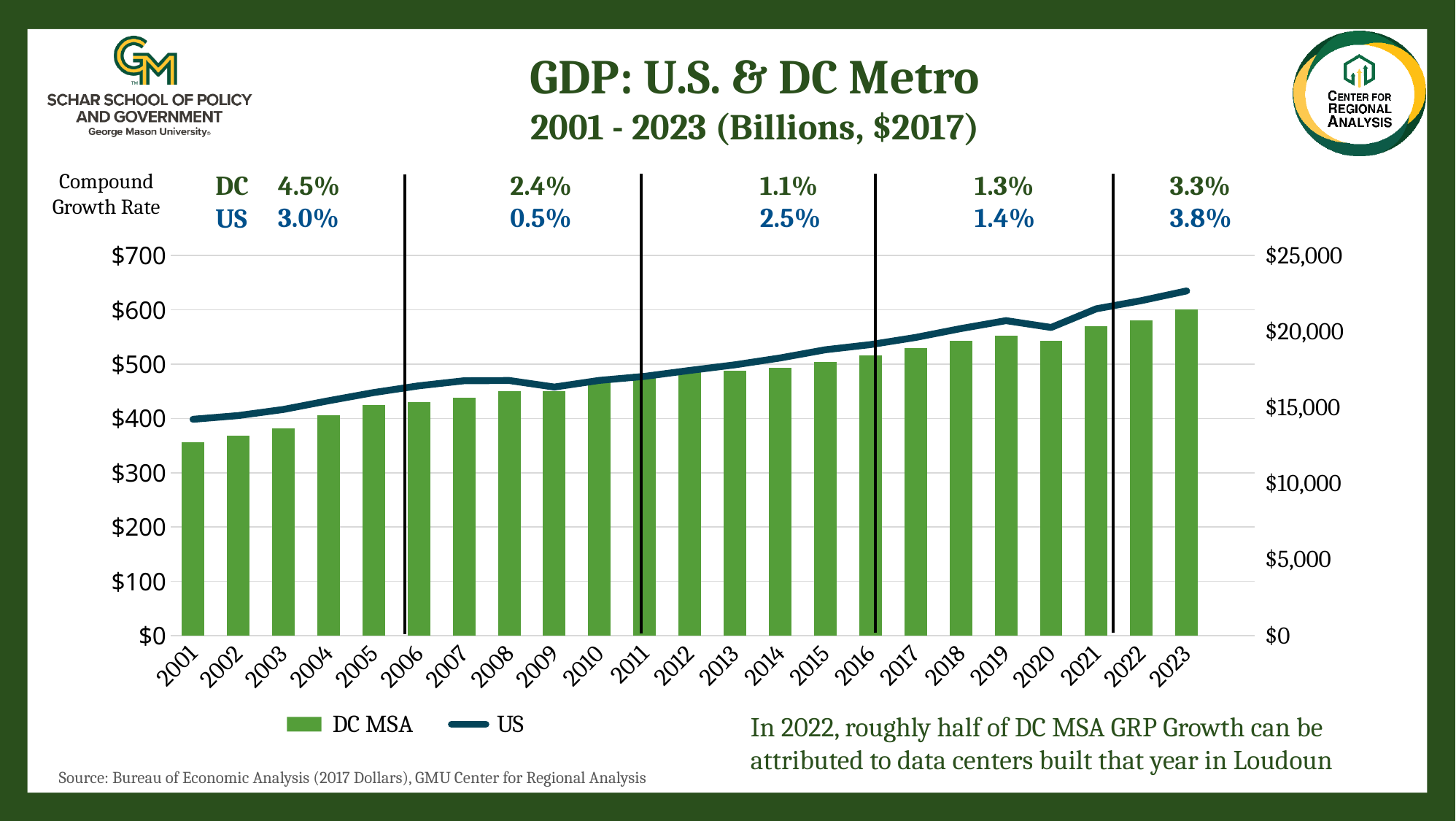
Which year has the highest DC MSA bar? 2023 Is the DC MSA value for 2023 greater or less than $500? greater What is the DC compound growth rate shown for the 2006–2011 period? 2.4% Is the DC MSA bar for 2021 taller or shorter than the bar for 2020? taller Do the DC MSA values generally rise or fall from 2001 to 2023? rise What is the US compound growth rate shown for the 2021–2023 period? 3.8% What kind of chart is shown on the slide? A combination bar and line chart Is the US value for 2023 on the right axis greater or less than $20,000? greater How many series does the legend list? 2 How many years are plotted along the x axis? 23 Which year has the lowest DC MSA bar? 2001 Is the DC MSA value for 2001 greater or less than $400? less